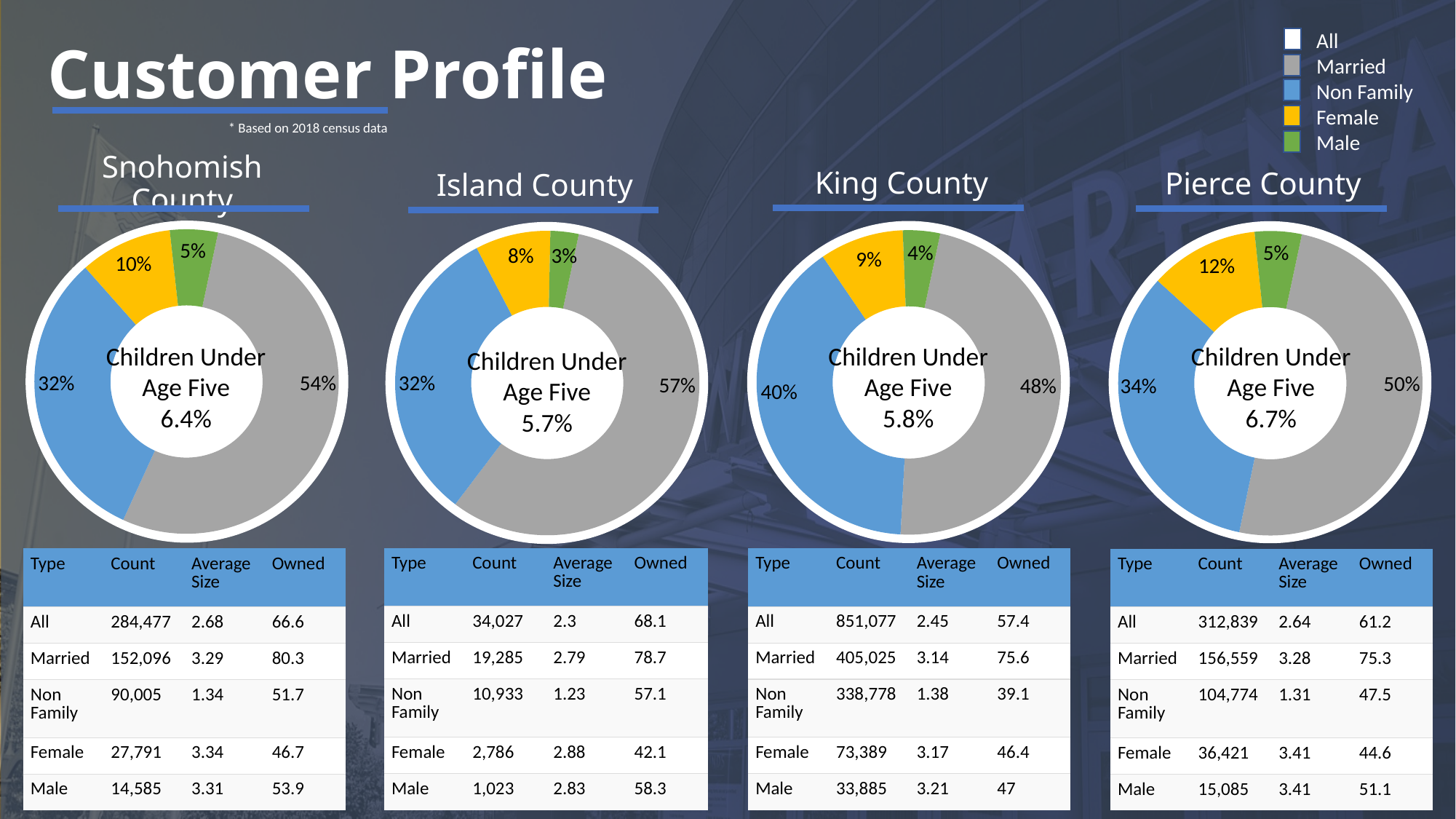
In the Pierce County chart, what percentage is shown for the Male slice? 5% In the Snohomish County chart, what percentage is shown for the Married slice? 54% In the Island County chart, what percentage is shown for the Non Family slice? 32% How many entries does the legend in the top right list? 5 What percentage of children under age five is shown in the center of the Pierce County chart? 6.7% In the King County chart, what percentage is shown for the Female slice? 9% In the King County chart, which slice is the largest? Married How many slices does the King County chart have? 4 In the Snohomish County chart, which is larger, the Female slice or the Male slice? Female What kind of chart is used for each county on this slide? Pie chart (donut) In the Island County chart, which slice is the smallest? Male In the Pierce County chart, what is the difference between the Married and Non Family percentages? 16%